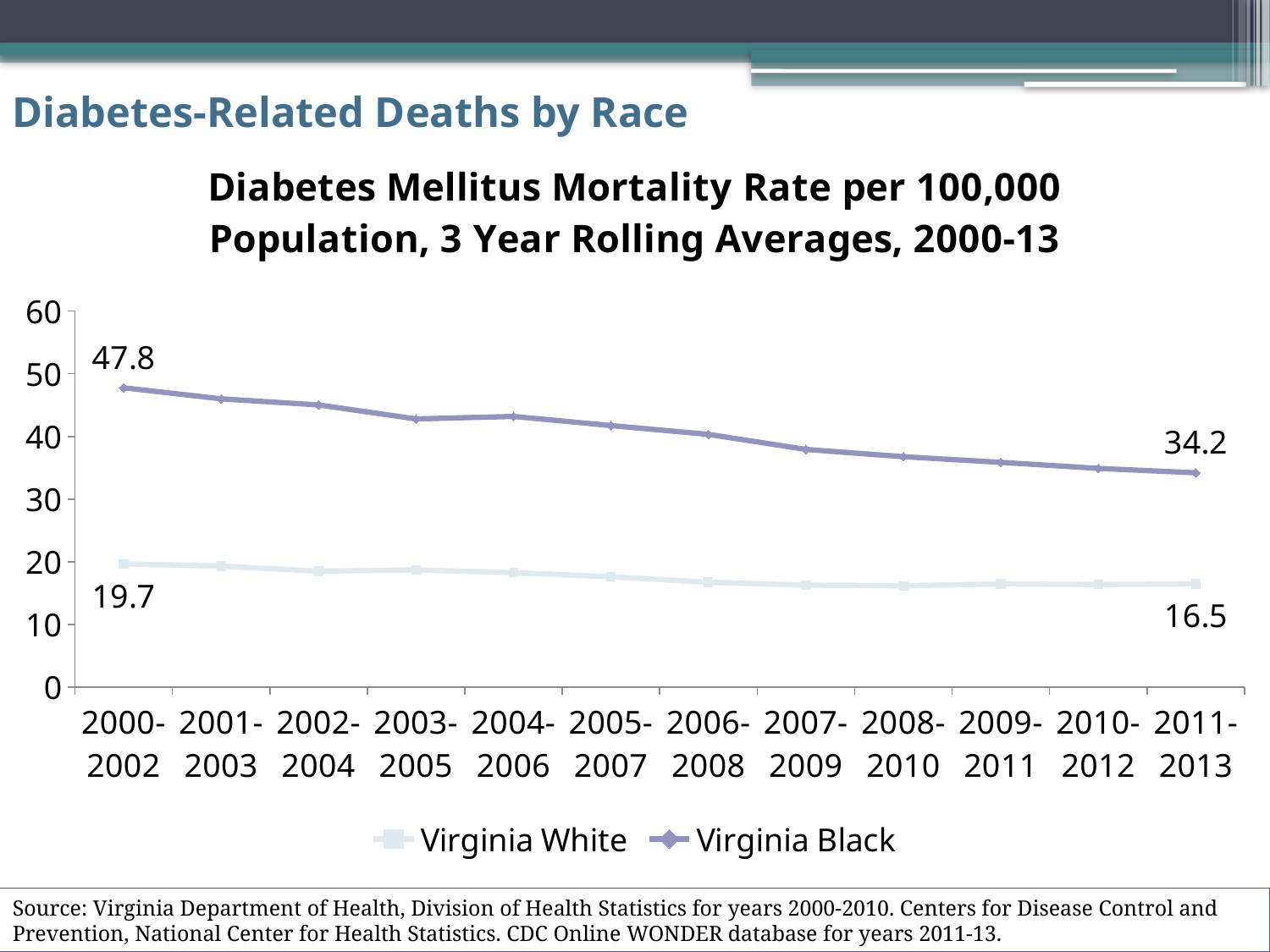
What kind of chart is shown on the slide? line chart What is the difference between the Virginia Black and Virginia White rates in 2011-2013? 17.7 How many time periods are shown on the x axis? 12 Which series has the higher mortality rate in 2005-2007, Virginia White or Virginia Black? Virginia Black Is the Virginia Black rate for 2007-2009 greater or less than 40? less What is the Virginia White diabetes mortality rate for 2000-2002? 19.7 How many series does the legend list? 2 What is the Virginia Black diabetes mortality rate for 2000-2002? 47.8 What is the Virginia Black diabetes mortality rate for 2011-2013? 34.2 Does the Virginia Black mortality rate rise or fall over the period shown? fall By how much did the Virginia Black mortality rate fall from 2000-2002 to 2011-2013? 13.6 What is the Virginia White diabetes mortality rate for 2011-2013? 16.5